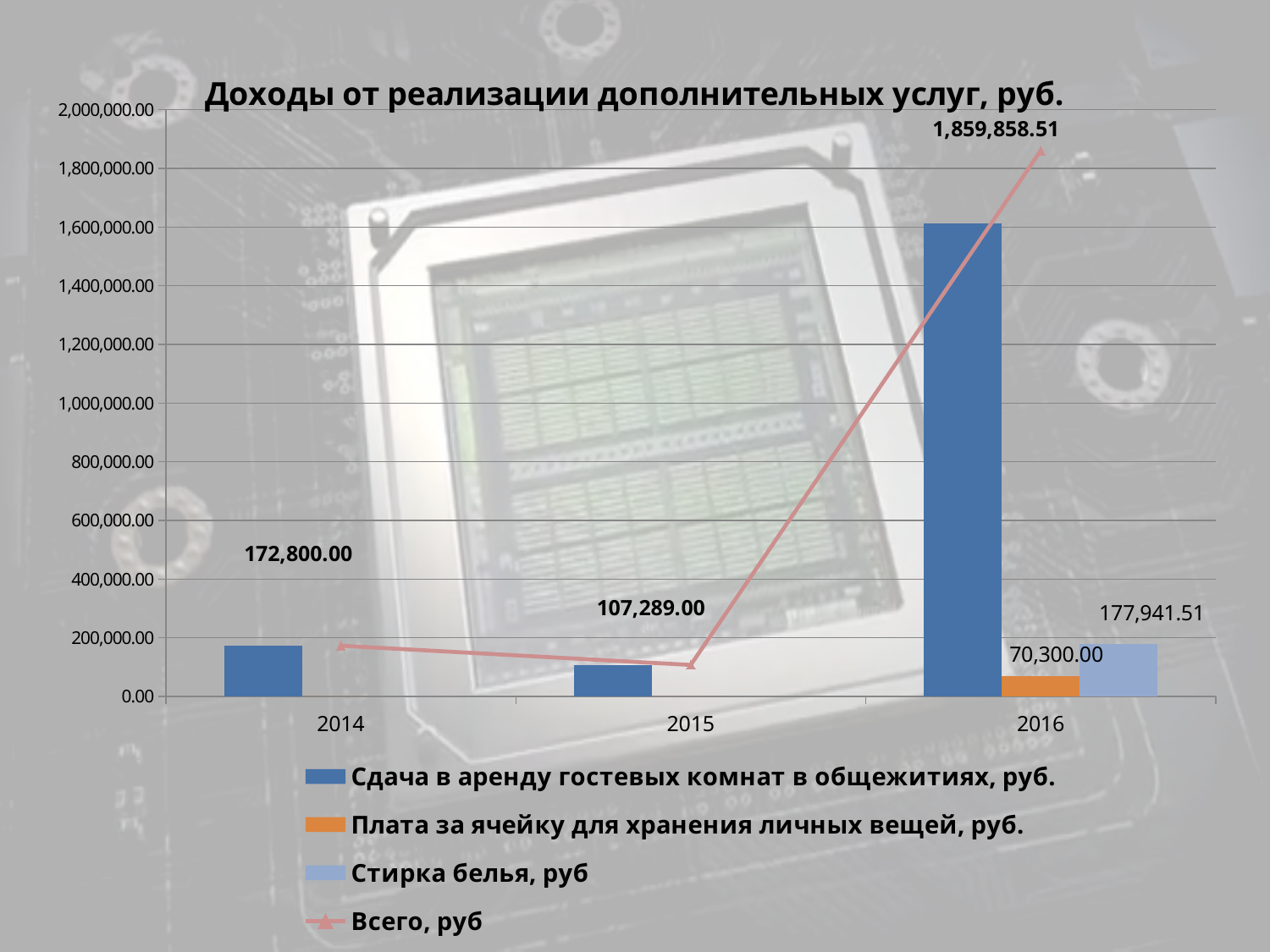
What is the value of 'Стирка белья, руб' in 2016? 177,941.51 What is the value of the 'Всего, руб' series for 2016? 1,859,858.51 What is the value of 'Плата за ячейку для хранения личных вещей, руб.' in 2016? 70,300.00 What is the value of the 'Всего, руб' series for 2014? 172,800.00 How many years are shown on the x axis? 3 Is the value for 'Сдача в аренду гостевых комнат в общежитиях, руб.' in 2016 greater or less than 1,400,000.00? greater What is the value of the 'Всего, руб' series for 2015? 107,289.00 How many series does the legend list? 4 What is the difference between the 'Всего, руб' values for 2014 and 2015? 65,511.00 In 2016, which is larger: 'Стирка белья, руб' or 'Плата за ячейку для хранения личных вещей, руб.'? Стирка белья, руб In which year is the 'Всего, руб' value the highest? 2016 In which year is the 'Всего, руб' value the lowest? 2015